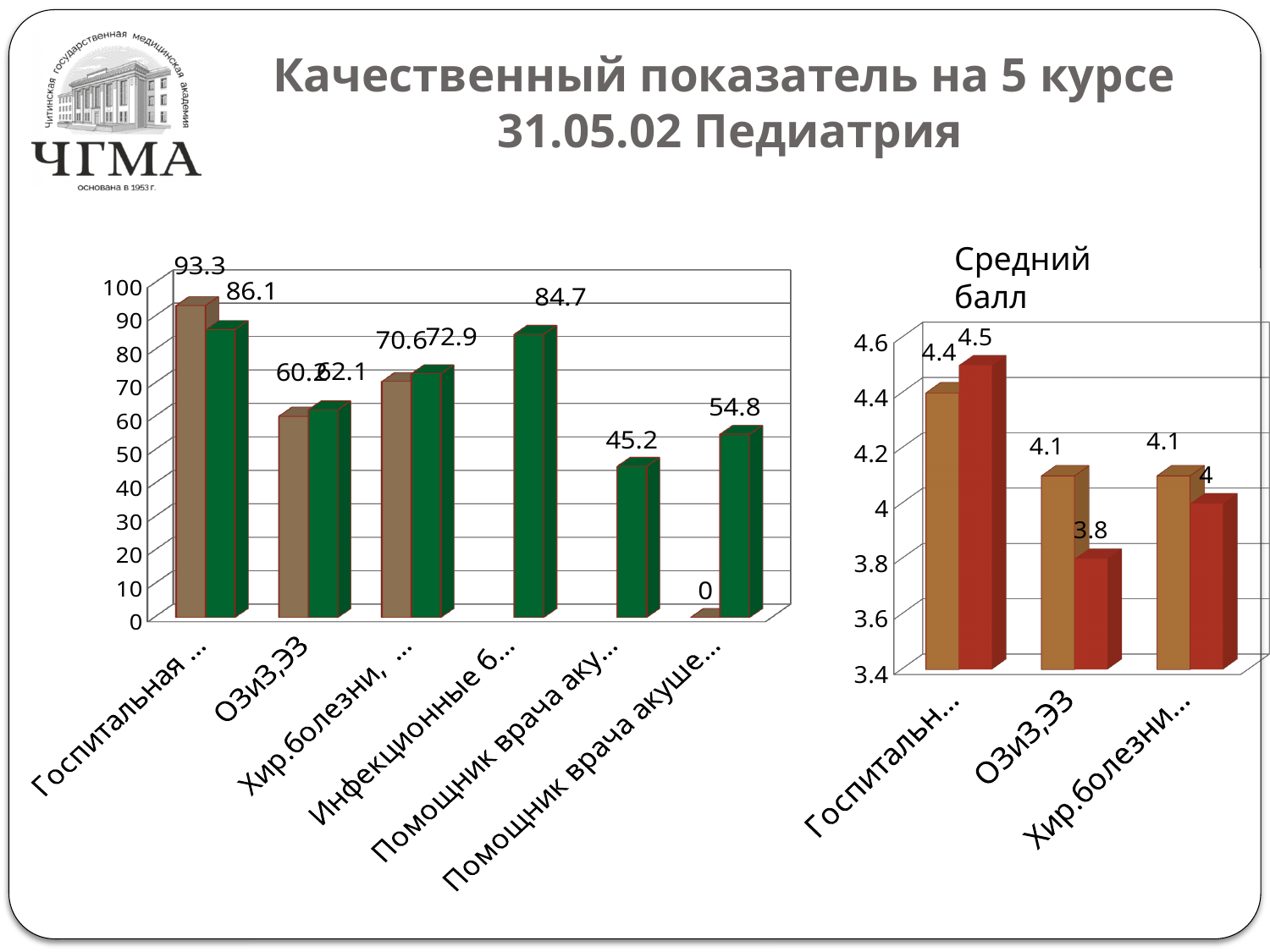
What is the title of the chart on the right side of the slide? Средний балл On the 'Средний балл' chart, what is the value of the red bar for 'ОЗиЗ,ЭЗ'? 3.8 On the left chart, what is the lowest value shown? 0 On the 'Средний балл' chart, what is the highest value shown? 4.5 On the left chart, what is the highest value shown? 93.3 On the left chart, how many categories are shown on the x axis? 6 On the 'Средний балл' chart, how many categories are shown on the x axis? 3 On the 'Средний балл' chart, what is the value of the brown bar for 'Госпитальн...'? 4.4 What kind of chart is the left chart? bar chart On the left chart, what is the value of the green bar for 'Инфекционные б...'? 84.7 On the left chart, what is the value of the green bar for 'Помощник врача аку...'? 45.2 On the left chart, what is the difference between the two bars for 'Госпитальная ...' (93.3 and 86.1)? 7.2